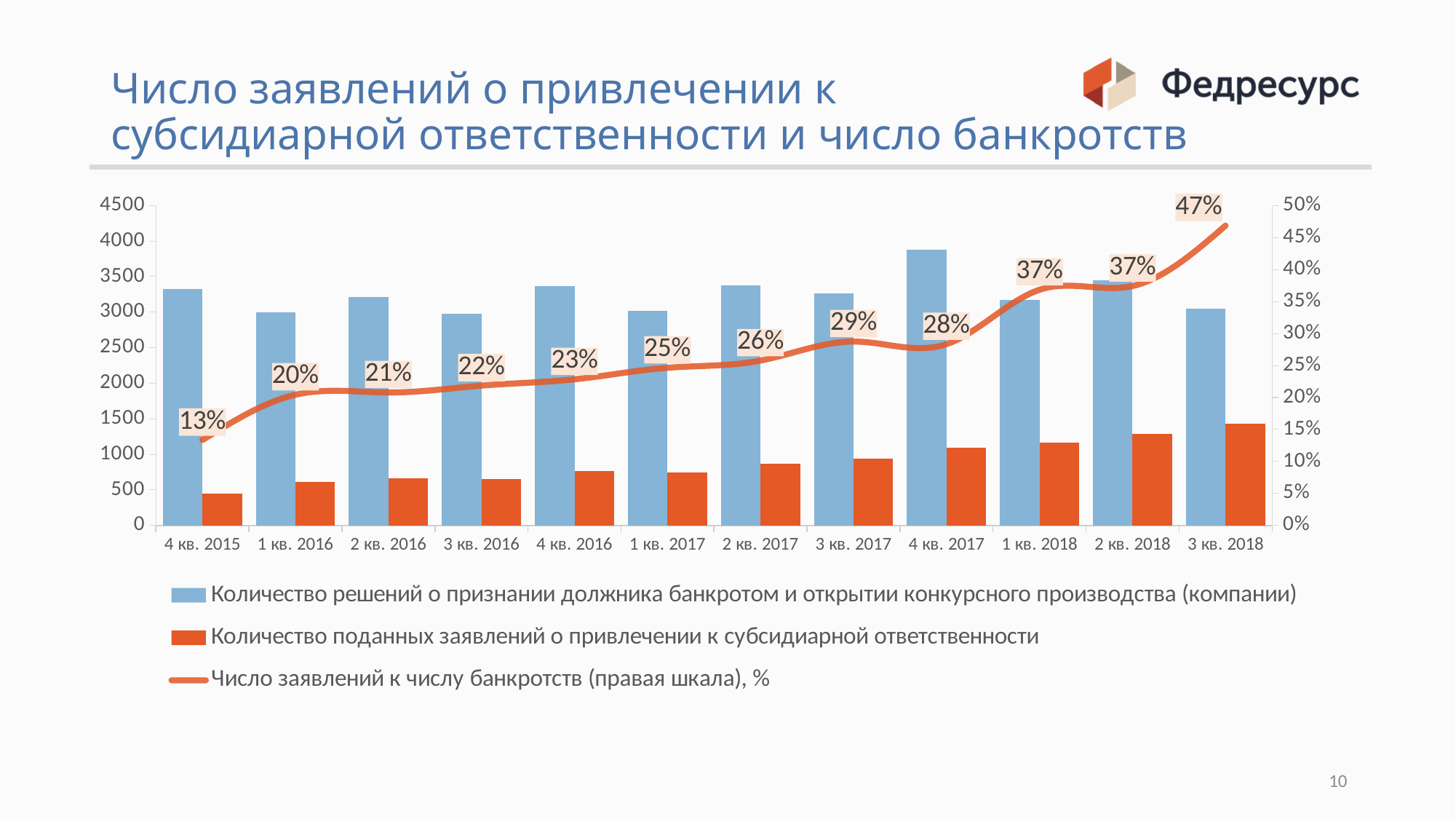
In which quarter is the ratio of applications to bankruptcies the lowest? 4 кв. 2015 How many quarters are shown on the x axis? 12 In which quarter is the ratio of applications to bankruptcies the highest? 3 кв. 2018 How many series does the legend list? 3 What is the ratio of applications to bankruptcies for 1 кв. 2018? 37% Do the orange bars (number of subsidiary liability applications) rise or fall from 4 кв. 2015 to 3 кв. 2018? rise What is the ratio of applications to bankruptcies (Число заявлений к числу банкротств) for 3 кв. 2018? 47% By how many percentage points does the ratio in 3 кв. 2018 exceed the ratio in 4 кв. 2015? 34 percentage points What is the ratio of applications to bankruptcies for 4 кв. 2015? 13% Which quarter has the higher ratio of applications to bankruptcies: 3 кв. 2017 or 4 кв. 2017? 3 кв. 2017 Is the number of subsidiary liability applications (orange bar) for 3 кв. 2018 greater or less than 1000? greater Is the number of bankruptcy decisions (blue bar) for 4 кв. 2017 greater or less than 3500? greater